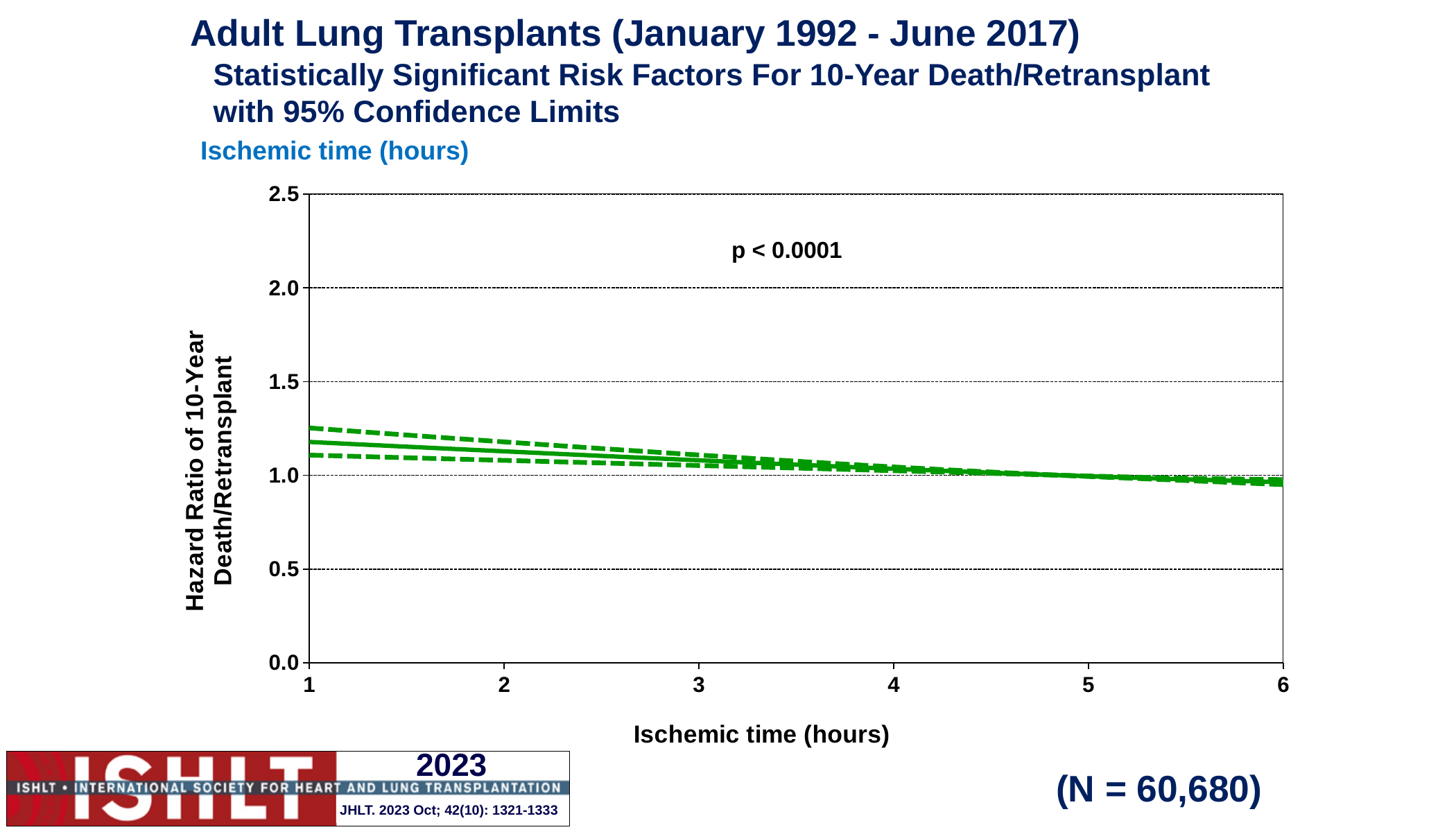
Is the hazard ratio at an ischemic time of 1 hour greater or less than 1.5? less What is the highest value shown on the y axis? 2.5 Which is larger, the hazard ratio at 1 hour or the hazard ratio at 6 hours of ischemic time? 1 hour What is the label of the x axis? Ischemic time (hours) How many lines are plotted on the chart? 3 Is the hazard ratio at an ischemic time of 1 hour greater or less than 1.0? greater Is the upper 95% confidence limit at an ischemic time of 2 hours greater or less than 1.5? less What p-value is printed on the chart? p < 0.0001 Does the hazard ratio rise or fall as ischemic time increases from 1 to 6 hours? fall What kind of chart is shown on the slide? line chart